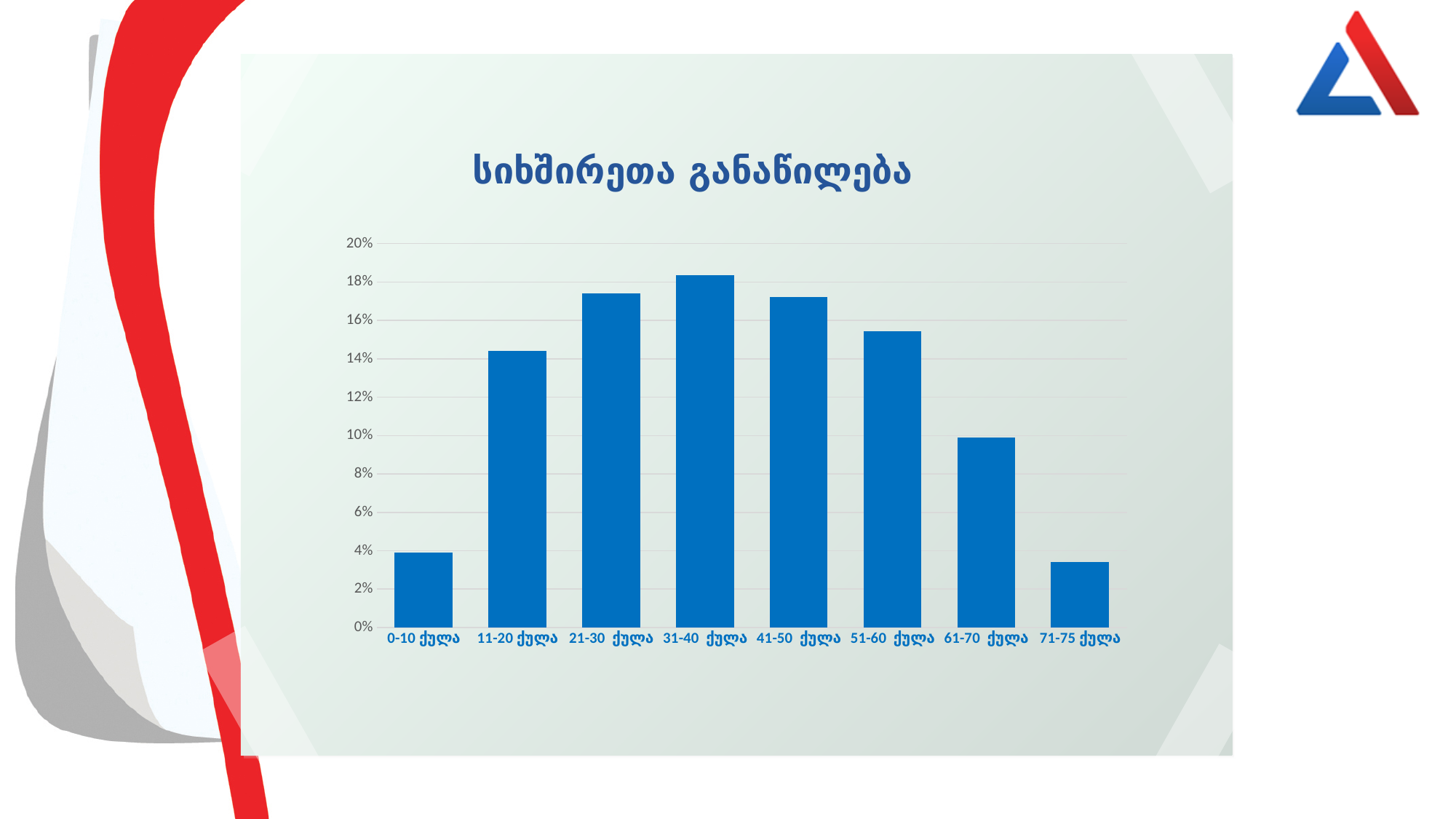
Is the value for 21-30 ქულა greater or less than 16%? greater Which is larger, the value for 11-20 ქულა or the value for 51-60 ქულა? 51-60 ქულა Is the value for 31-40 ქულა greater or less than 16%? greater Is the value for 61-70 ქულა greater or less than 12%? less What type of chart is shown on the slide? bar chart What is the title of the chart? სიხშირეთა განაწილება Which category has the highest bar? 31-40 ქულა How do the values change moving from left to right along the x axis? They rise to a peak at 31-40 ქულა and then fall How many score categories are shown on the x axis? 8 Which category has the lowest bar? 71-75 ქულა